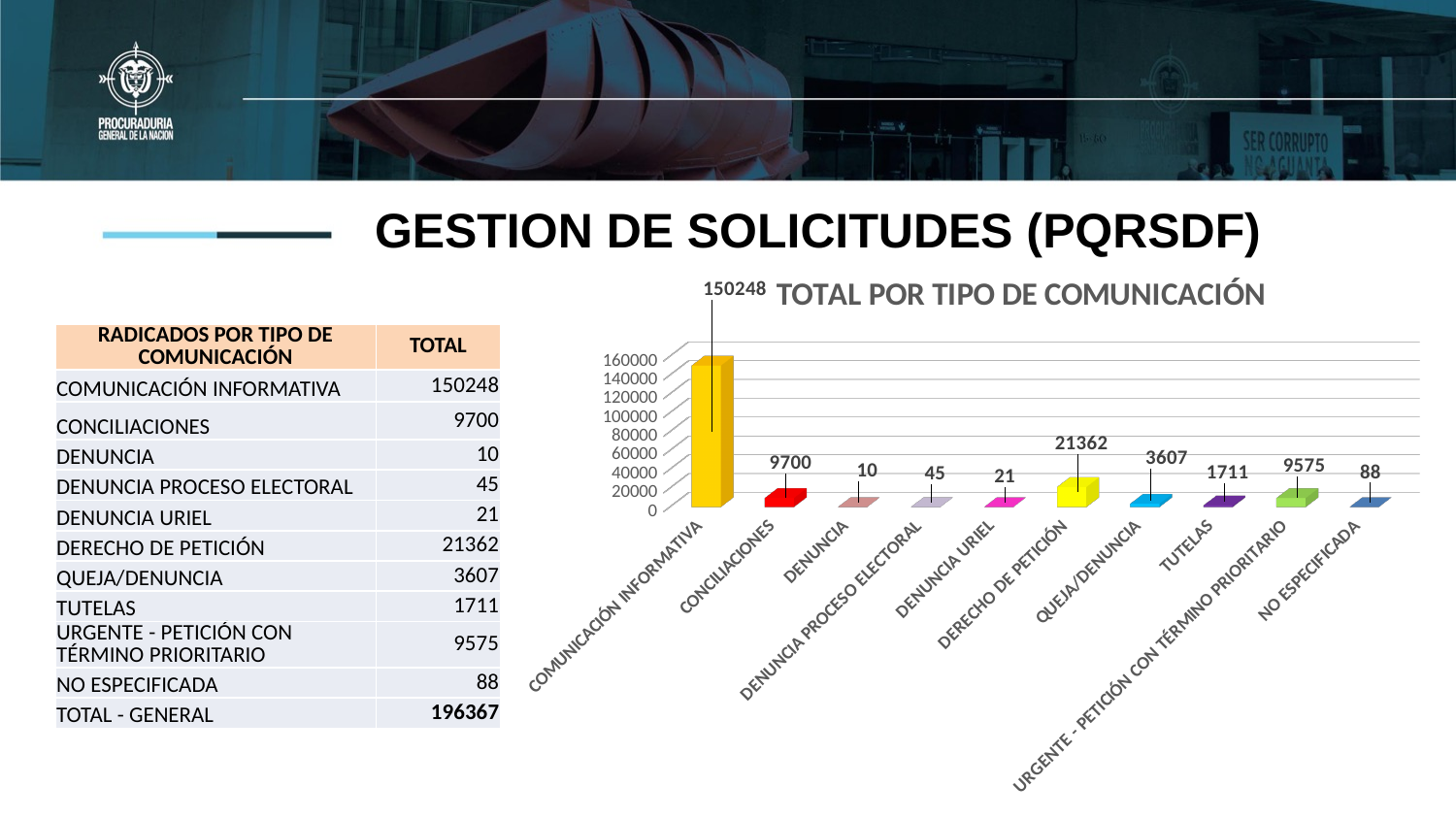
Which category has the lowest value in the chart? DENUNCIA Which category has the highest value in the chart? COMUNICACIÓN INFORMATIVA What is the difference between the values for DENUNCIA PROCESO ELECTORAL and DENUNCIA URIEL? 24 How many categories are plotted in the chart? 10 What is the difference between the values for DERECHO DE PETICIÓN and CONCILIACIONES? 11662 Is the value for COMUNICACIÓN INFORMATIVA greater or less than 140000? greater What is the title of the chart? TOTAL POR TIPO DE COMUNICACIÓN Which is larger, the value for QUEJA/DENUNCIA or the value for TUTELAS? QUEJA/DENUNCIA What kind of chart is shown on the slide? bar chart What is the value for COMUNICACIÓN INFORMATIVA in the chart? 150248 What is the value for URGENTE - PETICIÓN CON TÉRMINO PRIORITARIO in the chart? 9575 What is the value for DERECHO DE PETICIÓN in the chart? 21362